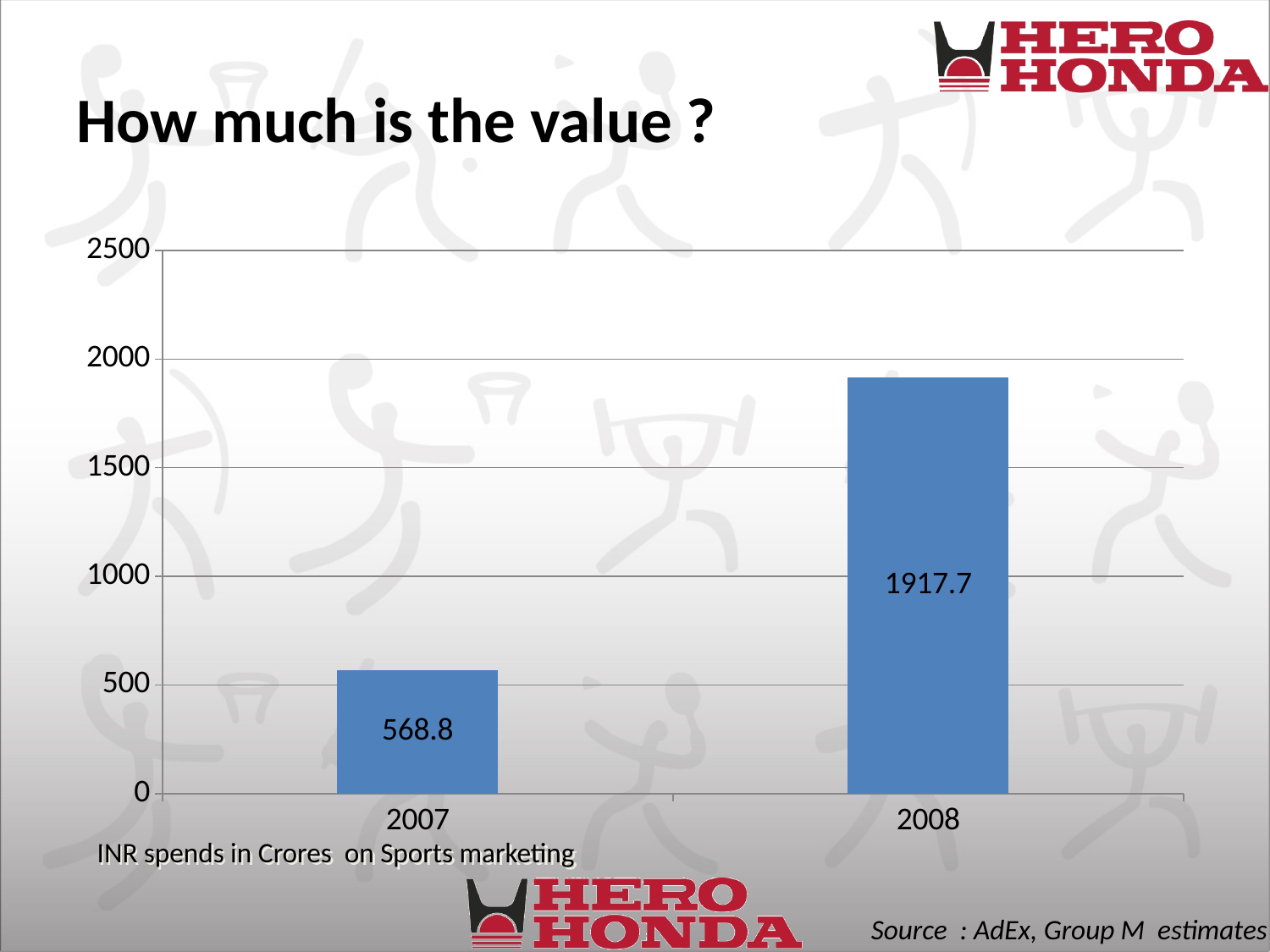
What is the difference between the 2008 and 2007 values? 1348.9 Do the values rise or fall from 2007 to 2008? Rise What kind of chart is shown on the slide? Bar chart What does the caption below the chart say the values represent? INR spends in Crores on Sports marketing Is the value for 2008 larger than the value for 2007? Yes How many years are shown on the chart? 2 Is the value for 2008 greater or less than 2000? less Which year has the lower value? 2007 What is the value for 2007? 568.8 What is the value for 2008? 1917.7 Which year has the higher value? 2008 Is the value for 2007 greater or less than 500? greater